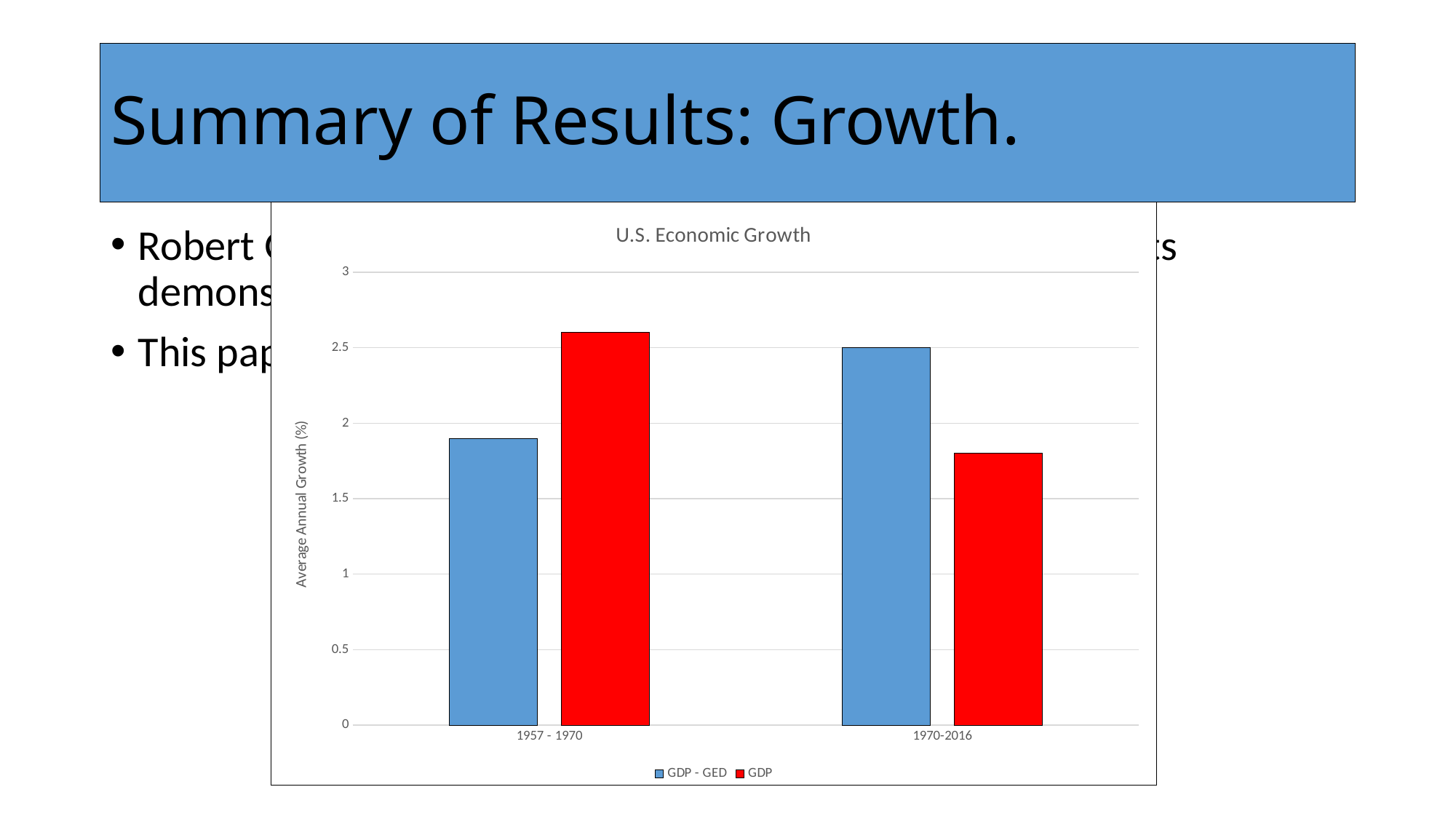
How many series does the chart's legend list? 2 What is the label of the y axis of the chart? Average Annual Growth (%) Is the GDP value for 1970-2016 greater or less than 2? less Is the GDP - GED value for 1957 - 1970 greater or less than 2? less What kind of chart is shown on the slide? bar chart How many categories are shown on the x axis of the chart? 2 For 1957 - 1970, which series has the larger value, GDP - GED or GDP? GDP What is the title of the chart? U.S. Economic Growth Is the GDP value for 1957 - 1970 greater or less than 2.5? greater For 1970-2016, which series has the larger value, GDP - GED or GDP? GDP - GED Does the GDP series rise or fall from 1957 - 1970 to 1970-2016? fall